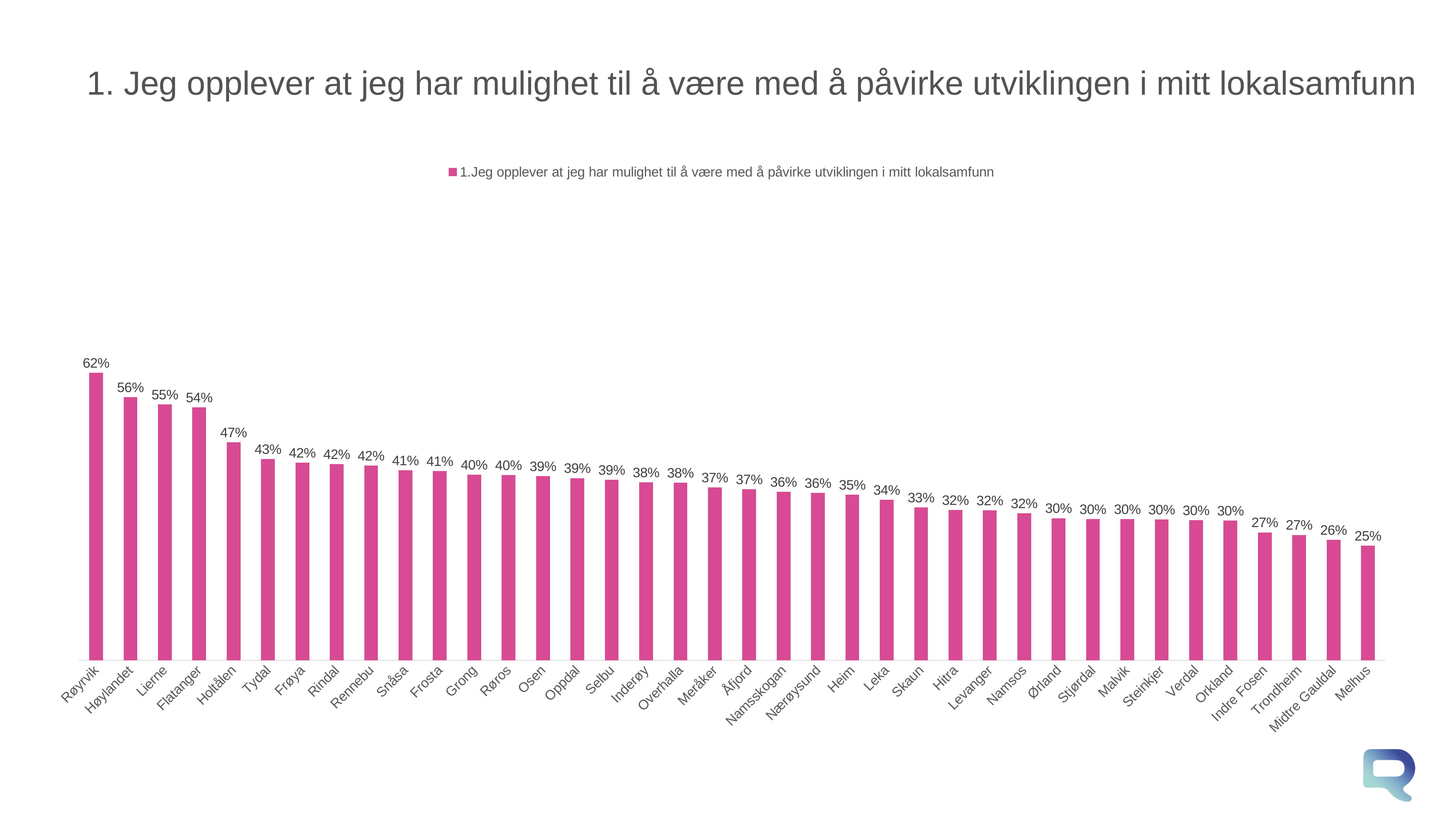
What is the difference between the values for Høylandet and Flatanger? 2% What is the value for Trondheim? 27% Which municipality has the lowest value? Melhus Which has a larger value, Tydal or Skaun? Tydal Which municipality has the highest value? Røyrvik What is the value for Leka? 34% Do the values rise or fall from left to right along the x axis? Fall What is the value for Holtålen? 47% What is the difference between the values for Røyrvik and Melhus? 37% What is the value for Røyrvik? 62% What kind of chart is shown on the slide? Bar chart How many municipalities are shown on the x axis? 38